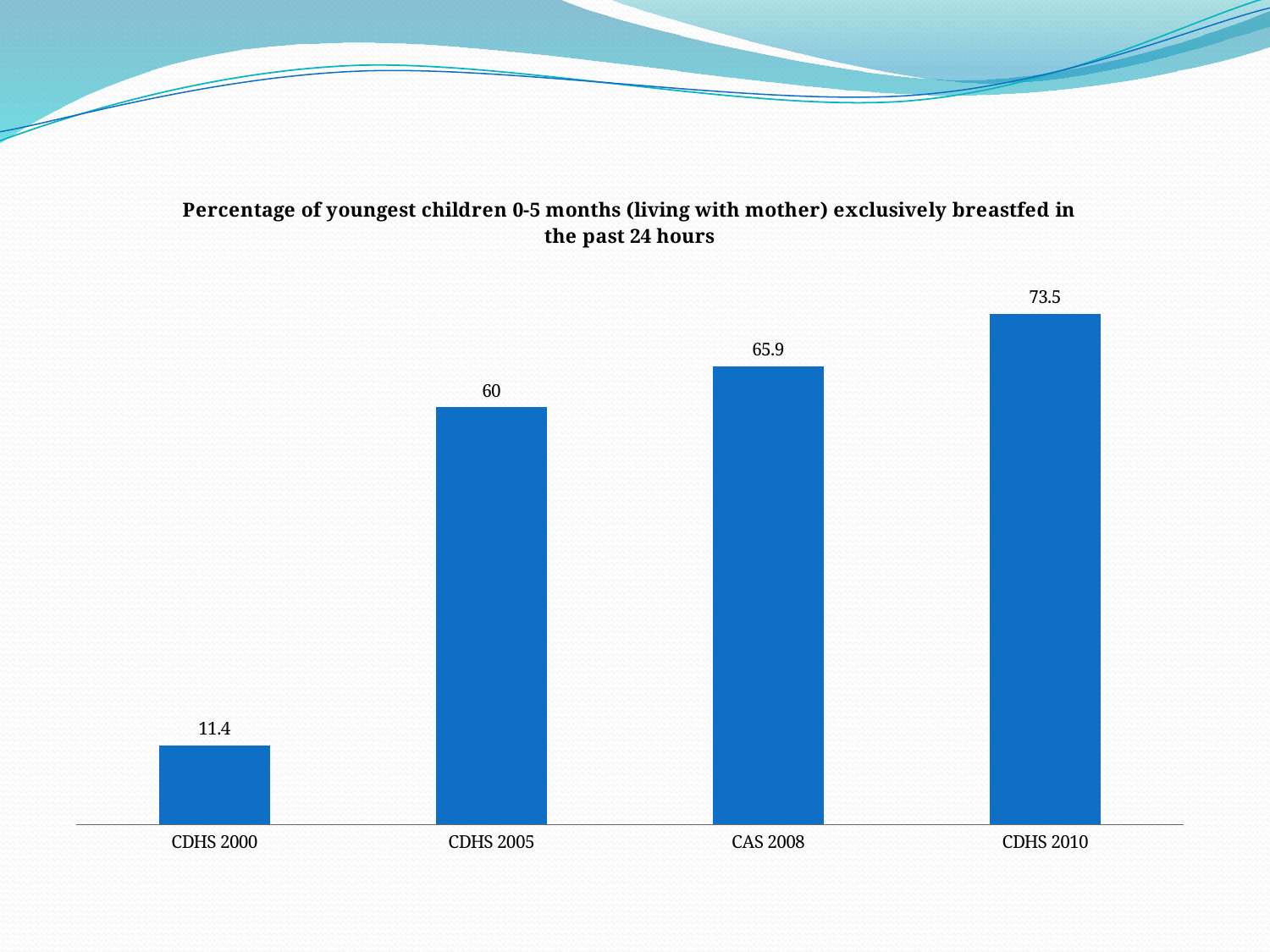
What is the difference between the values for CDHS 2010 and CDHS 2000? 62.1 What is the value for CDHS 2000? 11.4 How many categories are shown on the x axis? 4 Which category has the highest value? CDHS 2010 What is the value for CDHS 2010? 73.5 Which category has the lowest value? CDHS 2000 What is the value for CDHS 2005? 60 What is the difference between the values for CAS 2008 and CDHS 2005? 5.9 What kind of chart is this? Bar chart What is the value for CAS 2008? 65.9 Do the values rise or fall from CDHS 2000 to CDHS 2010? Rise Which is larger, the value for CDHS 2005 or the value for CAS 2008? CAS 2008